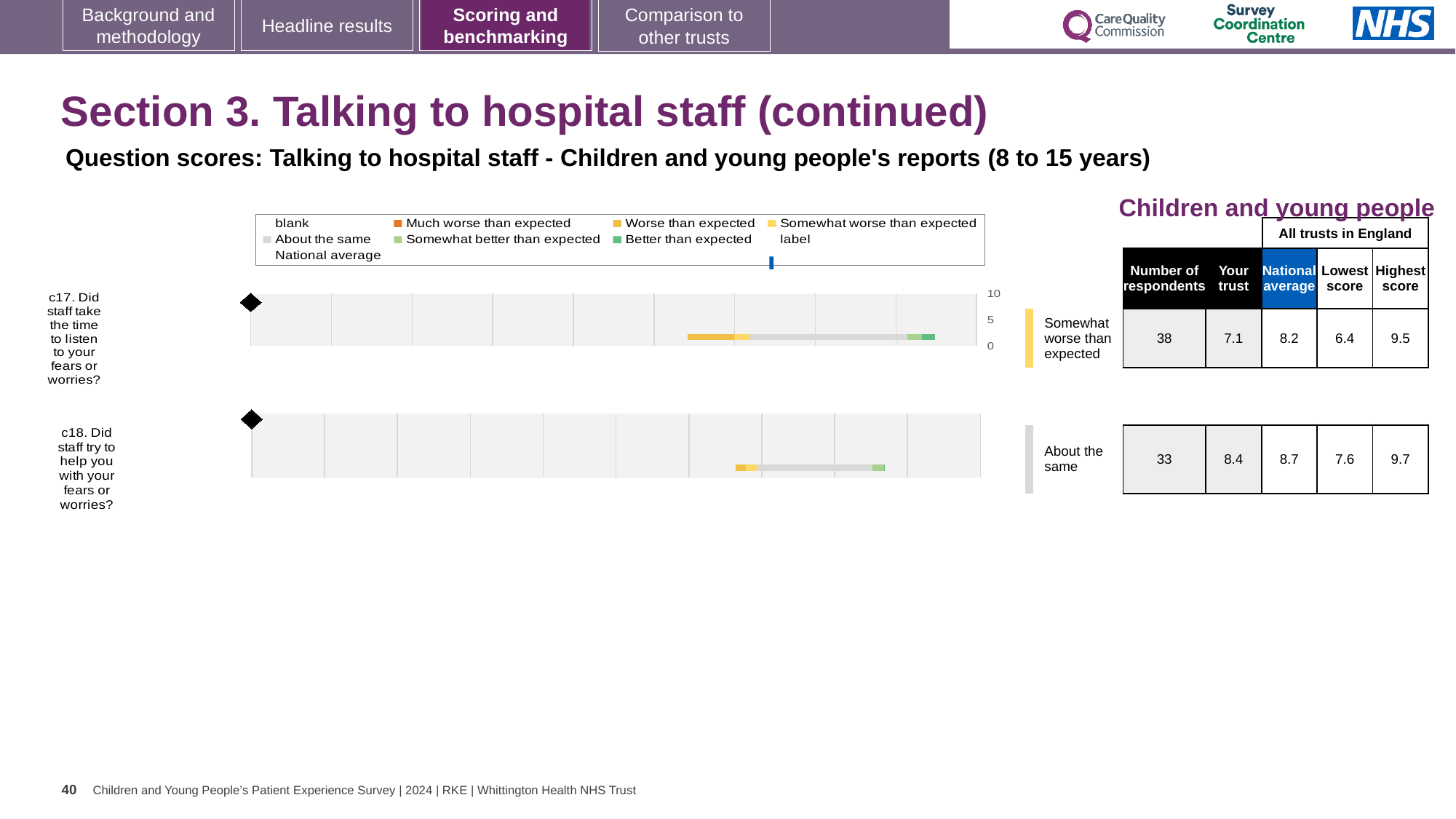
Which question has the lower number of respondents, c17 or c18? c18 What kind of chart is used to show the question scores? Bar chart What is the highest score among all trusts in England for question c18? 9.7 How many questions are plotted on the chart? 2 What benchmark category is shown for question c17? Somewhat worse than expected What is the 'Your trust' score for question c17 (Did staff take the time to listen to your fears or worries?)? 7.1 Which question has the higher 'Your trust' score, c17 or c18? c18 What is the lowest score among all trusts in England for question c17? 6.4 What is the difference between the national average and the trust score for question c17? 1.1 How many respondents answered question c17? 38 What is the difference between the highest and lowest scores for question c18? 2.1 What is the national average score for question c18 (Did staff try to help you with your fears or worries?)? 8.7